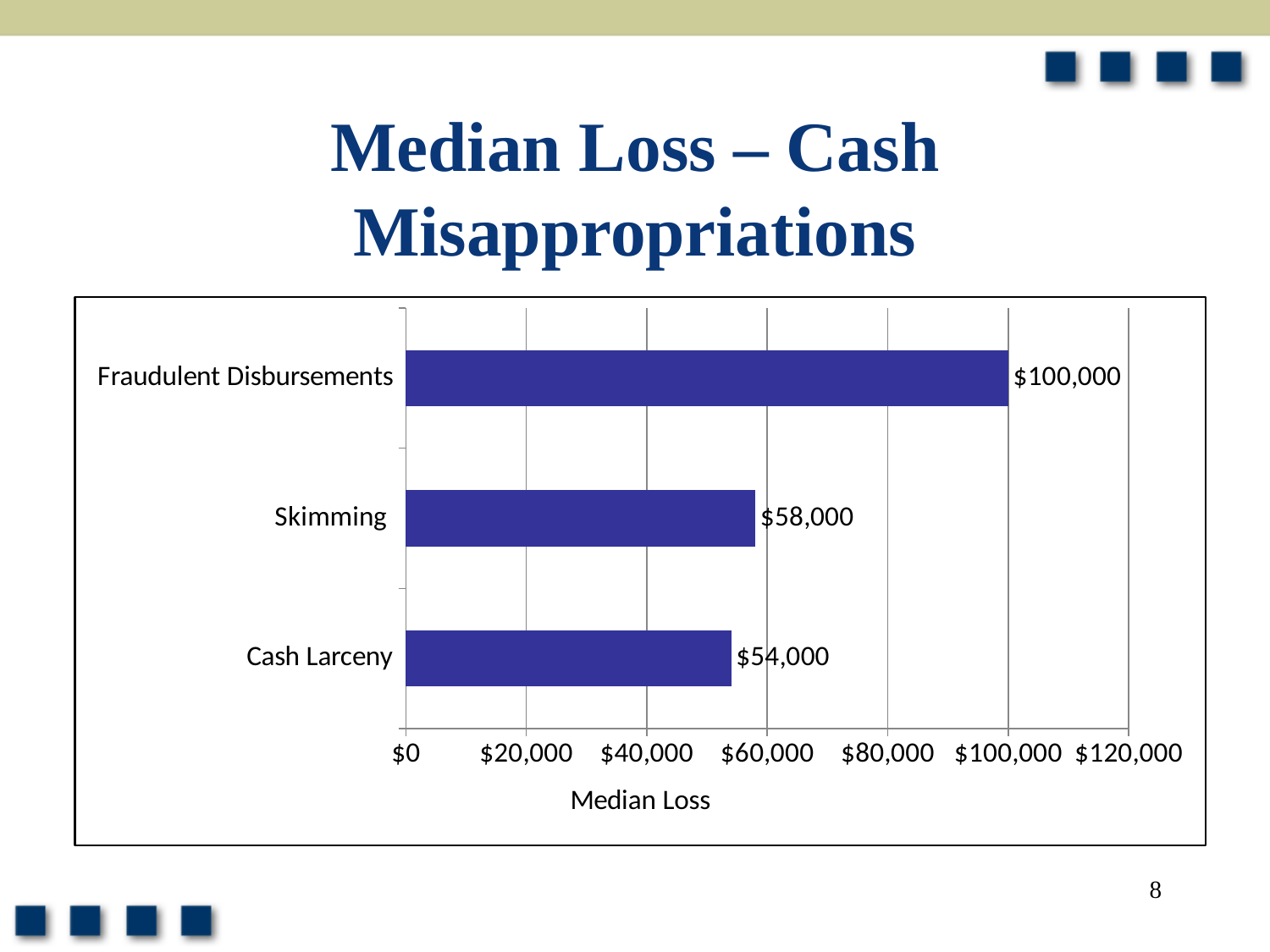
Is the median loss for Skimming greater or less than $60,000? less Which category has the highest median loss? Fraudulent Disbursements What is the median loss for Cash Larceny? $54,000 What is the difference in median loss between Skimming and Cash Larceny? $4,000 What kind of chart is shown on the slide? Bar chart What is the median loss for Skimming? $58,000 What is the median loss for Fraudulent Disbursements? $100,000 Which category has the lowest median loss? Cash Larceny What is the label on the horizontal axis of the chart? Median Loss What is the difference in median loss between Fraudulent Disbursements and Skimming? $42,000 Which has a larger median loss, Fraudulent Disbursements or Cash Larceny? Fraudulent Disbursements How many categories are shown in the chart? 3